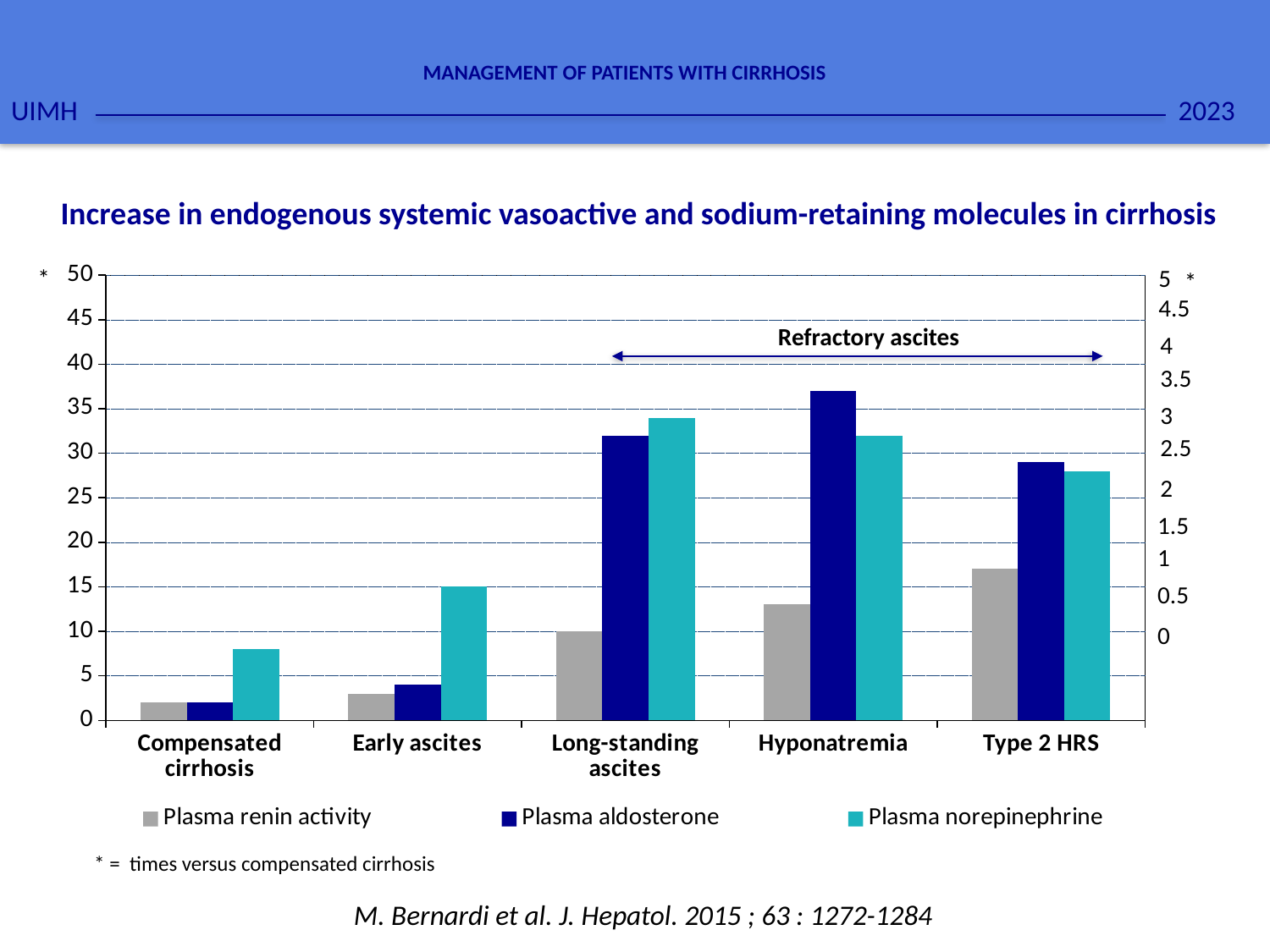
On the left axis, is the Plasma aldosterone value for Hyponatremia greater or less than 35? greater For Hyponatremia, which is larger: Plasma aldosterone or Plasma norepinephrine? Plasma aldosterone What kind of chart is shown on the slide? bar chart How many series does the legend list? 3 On the left axis, is the Plasma renin activity value for Type 2 HRS greater or less than 20? less Which category has the highest Plasma aldosterone bar? Hyponatremia What is the title of the chart? Increase in endogenous systemic vasoactive and sodium-retaining molecules in cirrhosis How many categories are shown along the x axis? 5 Which category has the highest Plasma renin activity bar? Type 2 HRS Which category has the lowest Plasma norepinephrine bar? Compensated cirrhosis Does Plasma renin activity rise or fall across the categories from left to right? rises For Early ascites, which is larger: Plasma norepinephrine or Plasma aldosterone? Plasma norepinephrine